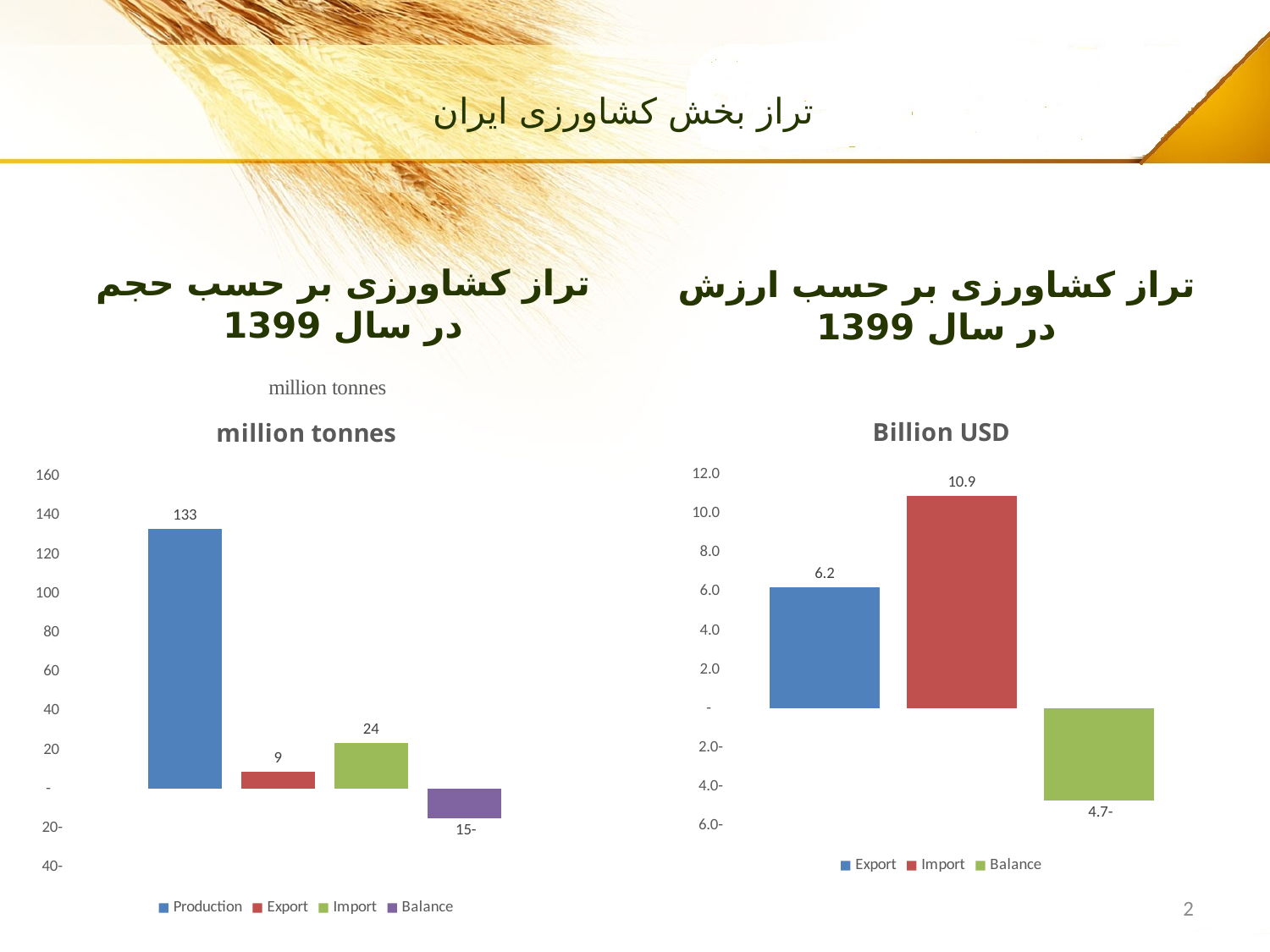
What type of chart is the 'Billion USD' chart? Bar chart In the 'million tonnes' chart, what is the value for Production? 133 How many series does the legend of the 'Billion USD' chart list? 3 In the 'million tonnes' chart, which series has the highest value? Production In the 'Billion USD' chart, what is the value for Export? 6.2 In the 'Billion USD' chart, what is the value for Import? 10.9 In the 'million tonnes' chart, what is the value for Import? 24 In the 'million tonnes' chart, what is the difference between Import and Export? 15 In the 'Billion USD' chart, which is larger, Export or Import? Import In the 'Billion USD' chart, what is the difference between Import and Export? 4.7 How many series does the legend of the 'million tonnes' chart list? 4 In the 'Billion USD' chart, which series has the lowest value? Balance